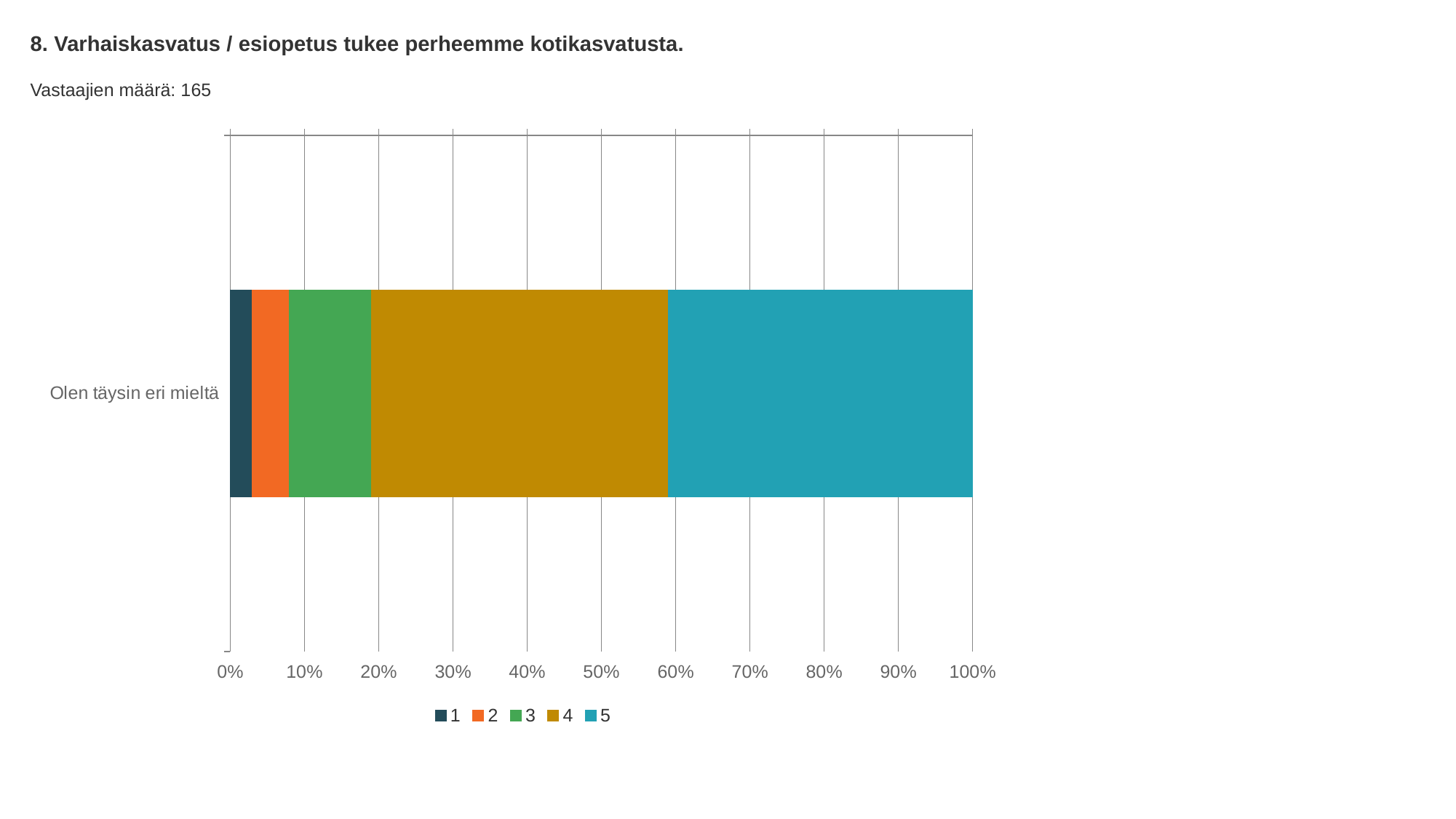
How many categories (bars) are plotted in the chart? 1 What is the total of the stacked bar, as shown by where it ends on the x axis? 100% Which series has a larger share of the bar, series 2 or series 3? 3 Which series occupies the smallest share of the stacked bar? 1 Is the share for series 3 greater or less than 20%? less How many series does the legend list? 5 How many respondents (Vastaajien määrä) are reported on the slide? 165 Is the share for series 5 greater or less than 30%? greater Which series occupies the largest share of the stacked bar? 5 What is the label of the single category on the y axis? Olen täysin eri mieltä What kind of chart is shown on the slide? Stacked bar chart Is the share for series 1 greater or less than 10%? less